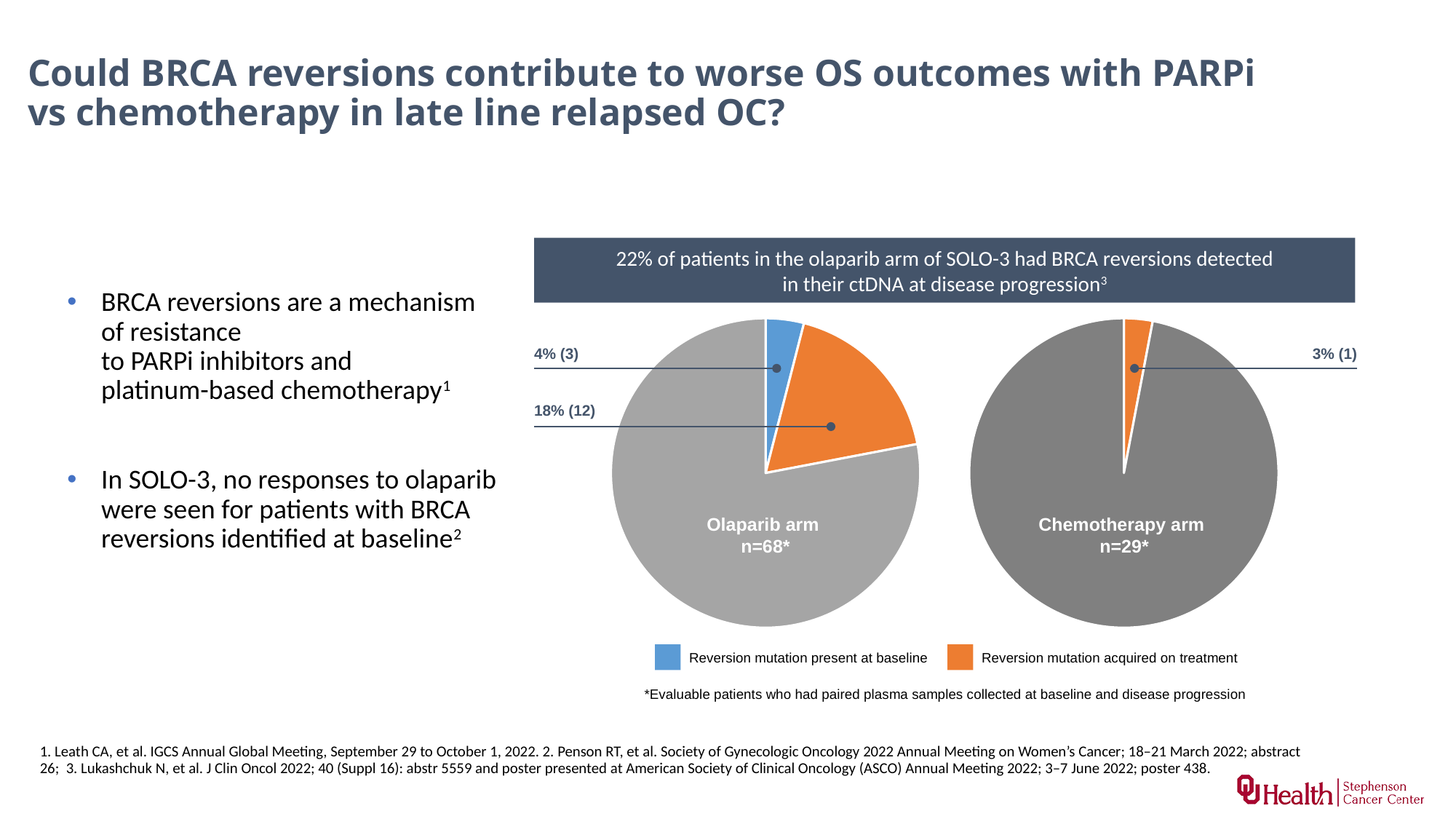
In the Olaparib arm pie chart, what percentage of patients had a reversion mutation present at baseline? 4% (3) What kind of charts are shown on the slide? Pie charts How many entries does the legend below the pie charts list? 2 In the Olaparib arm pie chart, which is larger: the share with a reversion mutation present at baseline or the share acquired on treatment? Acquired on treatment In the Olaparib arm pie chart, how many patients in total had a BRCA reversion detected (baseline plus acquired on treatment)? 15 Which colour represents 'Reversion mutation acquired on treatment' in the pie charts? Orange In the Olaparib arm pie chart, what is the difference in percentage points between the share acquired on treatment and the share present at baseline? 14 percentage points In the Olaparib arm pie chart, what percentage of patients had a reversion mutation acquired on treatment? 18% (12) How many evaluable patients are in the Chemotherapy arm pie chart? n=29* In the Chemotherapy arm pie chart, what percentage of patients had a reversion mutation acquired on treatment? 3% (1) According to the banner above the pie charts, what percentage of patients in the olaparib arm of SOLO-3 had BRCA reversions detected in their ctDNA at disease progression? 22% How many evaluable patients are in the Olaparib arm pie chart? n=68*